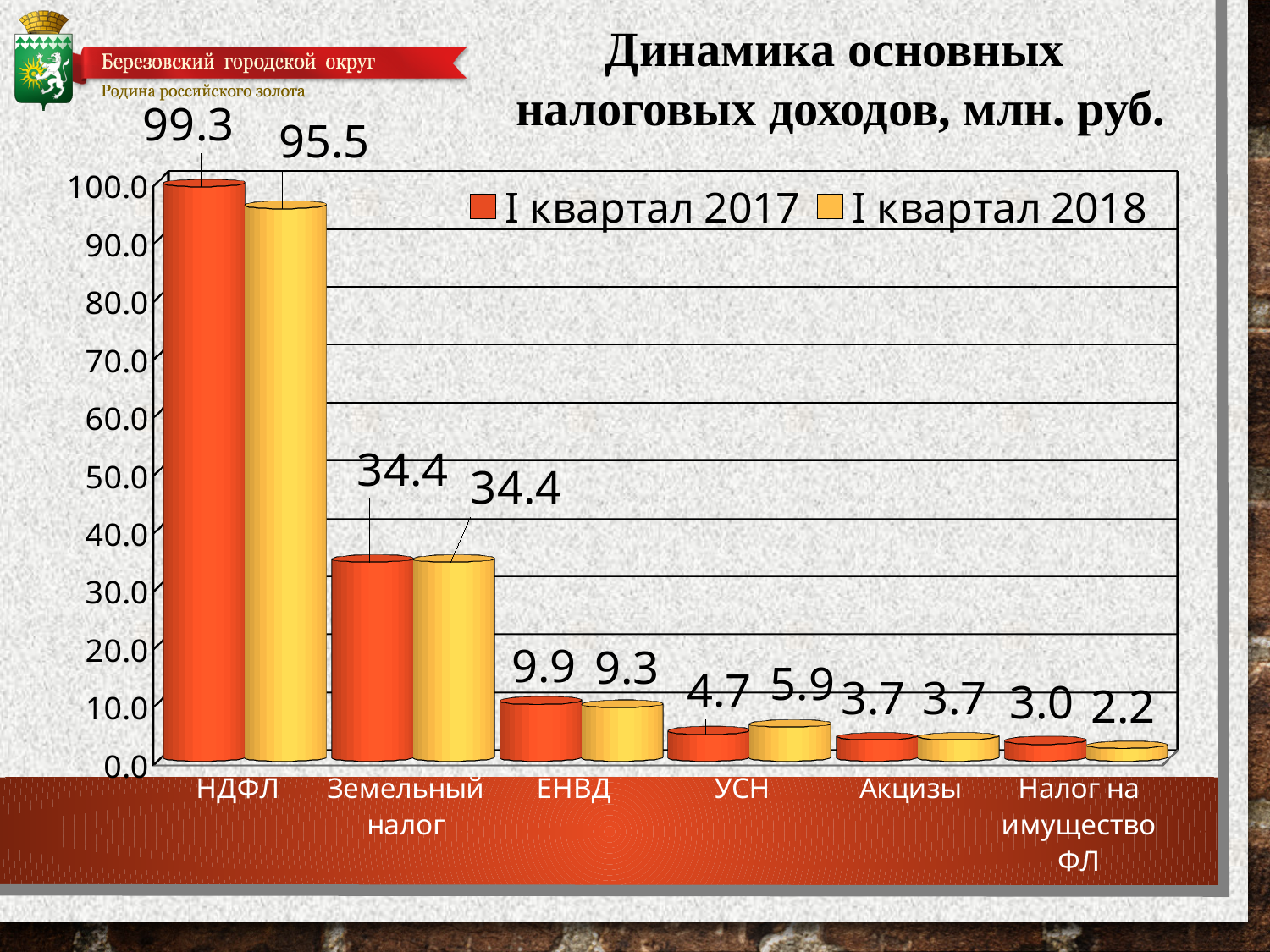
What is the value for Налог на имущество ФЛ in I квартал 2017? 3.0 What is the difference between the I квартал 2017 and I квартал 2018 values for НДФЛ? 3.8 Which is larger for ЕНВД: the I квартал 2017 value or the I квартал 2018 value? I квартал 2017 What kind of chart is shown on the slide? Bar chart Which category has the highest value in I квартал 2017? НДФЛ What is the title of the chart? Динамика основных налоговых доходов, млн. руб. How many series does the legend list? 2 What is the value for НДФЛ in I квартал 2018? 95.5 Which category has the lowest value in I квартал 2018? Налог на имущество ФЛ How many categories are shown on the x axis? 6 What is the value for НДФЛ in I квартал 2017? 99.3 What is the value for УСН in I квартал 2018? 5.9